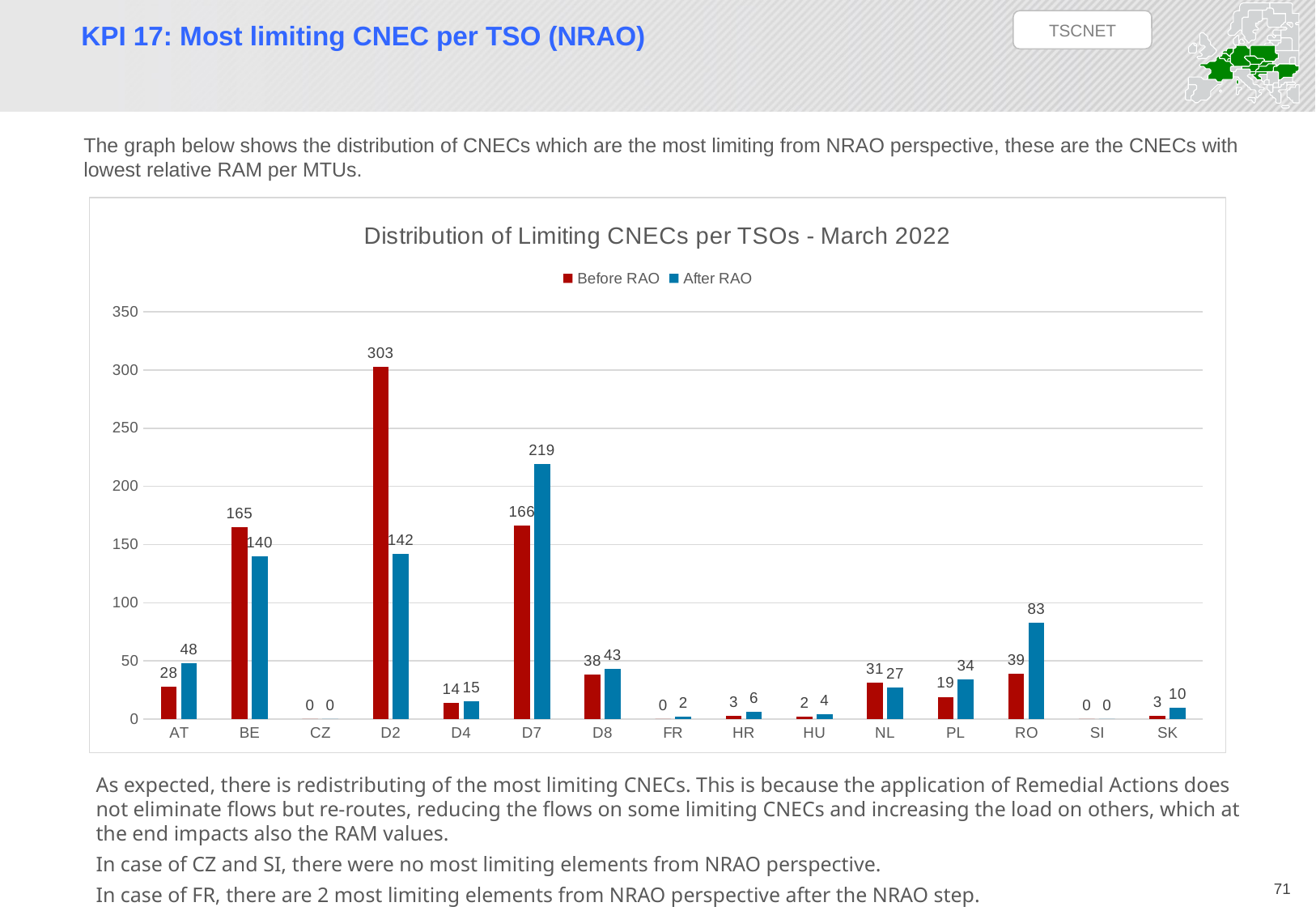
How many series does the legend list? 2 For NL, which is larger: the Before RAO value or the After RAO value? Before RAO What kind of chart is shown? Bar chart Which TSO has the highest Before RAO value? D2 What is the After RAO value for D7? 219 What is the title of the chart? Distribution of Limiting CNECs per TSOs - March 2022 What is the After RAO value for RO? 83 Which TSO has the highest After RAO value? D7 What is the difference between the Before RAO and After RAO values for BE? 25 How many TSO categories are shown on the x axis? 15 What is the Before RAO value for D2? 303 What is the difference between the Before RAO and After RAO values for D2? 161